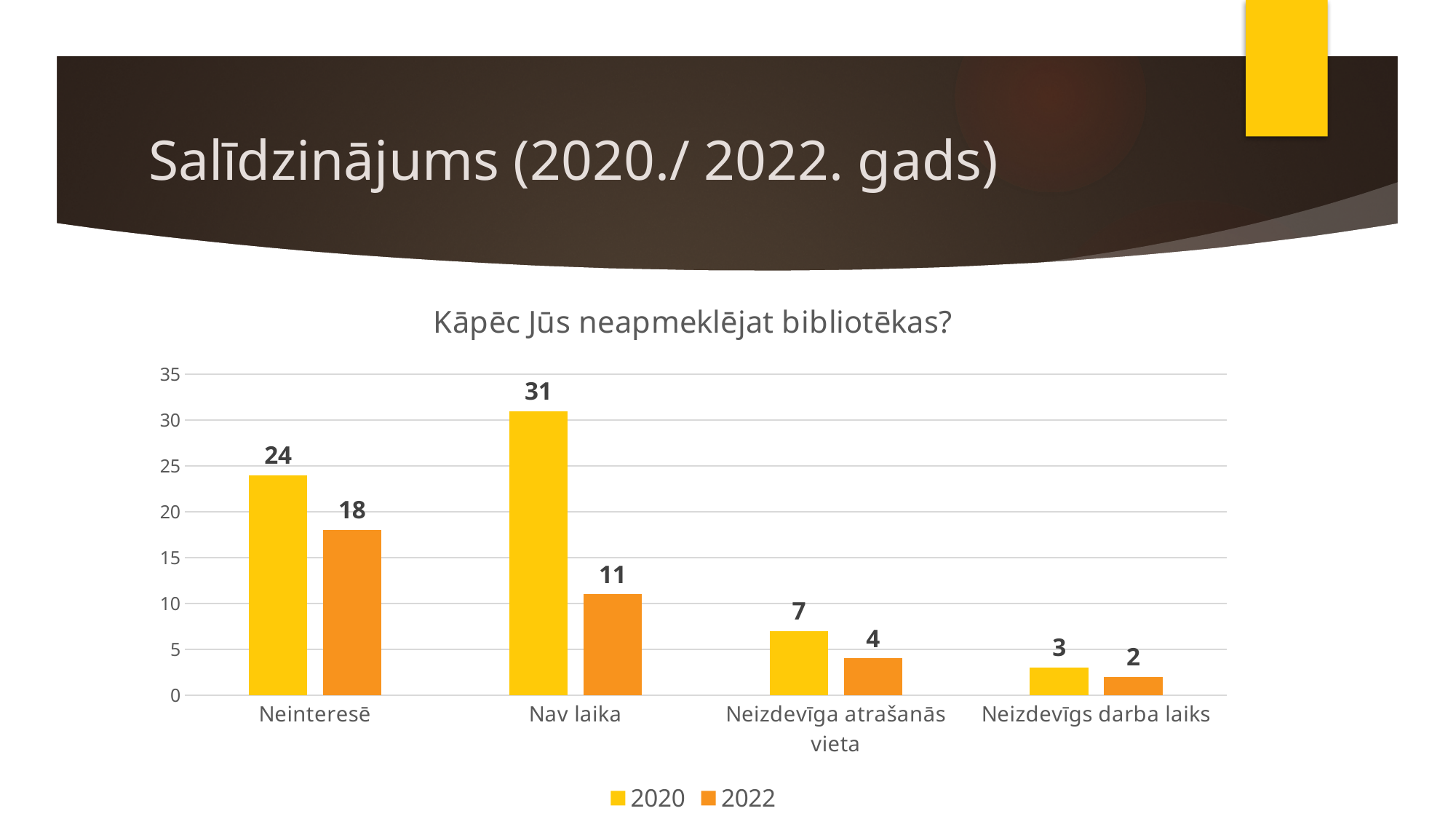
What is the difference between the 2020 and 2022 values for Nav laika? 20 What is the 2022 value for Neinteresē? 18 How many categories are shown on the x axis? 4 How many series does the legend list? 2 What is the difference between the 2020 values for Neinteresē and Neizdevīga atrašanās vieta? 17 Which category has the highest 2020 value? Nav laika What is the 2022 value for Neizdevīga atrašanās vieta? 4 What kind of chart is shown on the slide? Bar chart What is the title of the chart? Kāpēc Jūs neapmeklējat bibliotēkas? Which category has the lowest 2022 value? Neizdevīgs darba laiks What is the 2020 value for Nav laika? 31 Which is larger: the 2020 value for Neinteresē or the 2022 value for Neinteresē? 2020 value for Neinteresē